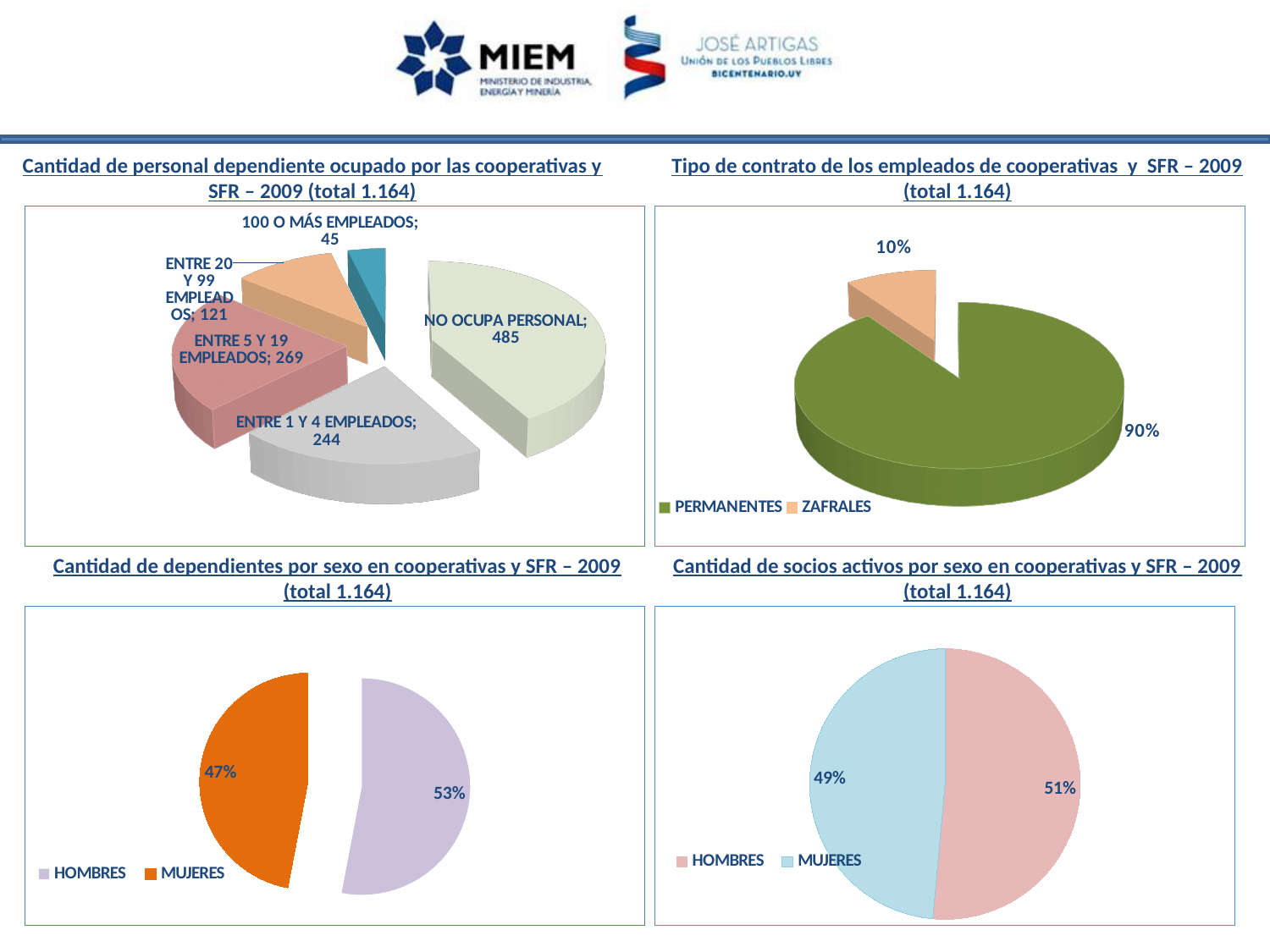
In the top-left chart (Cantidad de personal dependiente ocupado), what is the difference between ENTRE 5 Y 19 EMPLEADOS and ENTRE 1 Y 4 EMPLEADOS? 25 In the top-right chart (Tipo de contrato de los empleados), what share is PERMANENTES? 90% In the bottom-left chart (Cantidad de dependientes por sexo), what share is MUJERES? 47% In the top-left chart (Cantidad de personal dependiente ocupado), what is the value for ENTRE 5 Y 19 EMPLEADOS? 269 In the top-right chart (Tipo de contrato de los empleados), what share is ZAFRALES? 10% In the top-left chart (Cantidad de personal dependiente ocupado), which category has the smallest value? 100 O MÁS EMPLEADOS In the top-left chart (Cantidad de personal dependiente ocupado), what is the value for NO OCUPA PERSONAL? 485 In the bottom-left chart (Cantidad de dependientes por sexo), which is larger, HOMBRES or MUJERES? HOMBRES In the top-left chart (Cantidad de personal dependiente ocupado), which category has the largest value? NO OCUPA PERSONAL In the top-left chart (Cantidad de personal dependiente ocupado), how many categories are shown? 5 What kind of chart is the bottom-right chart (Cantidad de socios activos por sexo)? Pie chart